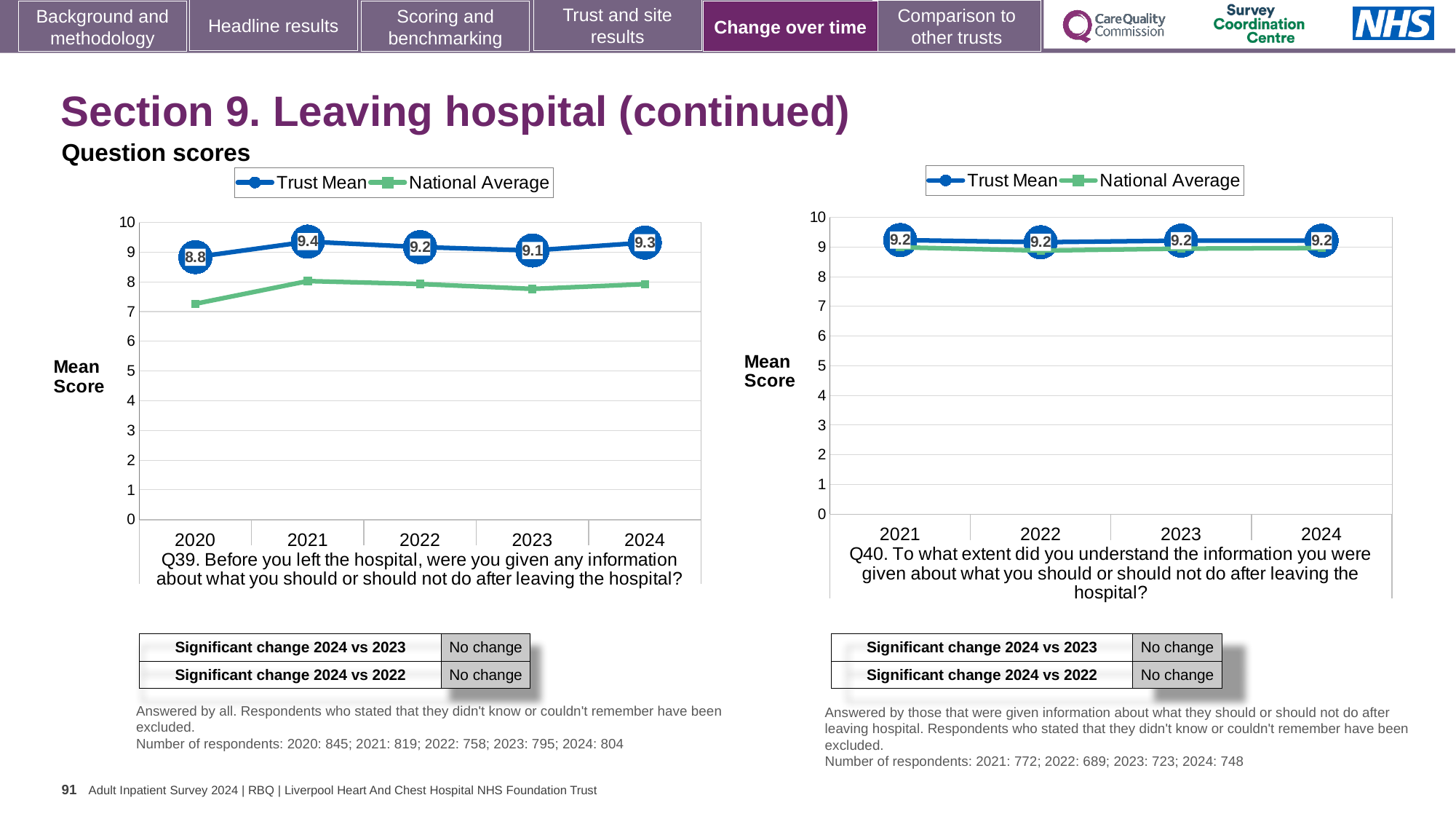
In the Q40 chart on the right, does the Trust Mean score rise, fall or stay the same from 2021 to 2024? stays the same In the Q39 chart on the left, is the Trust Mean score for 2023 higher or lower than for 2024? lower In the Q39 chart on the left, which year has the lowest Trust Mean score? 2020 In the Q40 chart on the right, what is the Trust Mean score for 2022? 9.2 In the Q39 chart on the left, which year has the highest Trust Mean score? 2021 In the Q39 chart on the left, what is the Trust Mean score for 2020? 8.8 In the Q39 chart on the left, what is the difference between the Trust Mean scores for 2021 and 2020? 0.6 In the Q39 chart on the left, what is the Trust Mean score for 2024? 9.3 In the Q39 chart on the left, how many years are shown on the x axis? 5 What type of chart is used for the Q40 chart on the right? line chart In the Q40 chart on the right, how many series does the legend list? 2 In the Q39 chart on the left, is the National Average for 2020 greater or less than 8? less